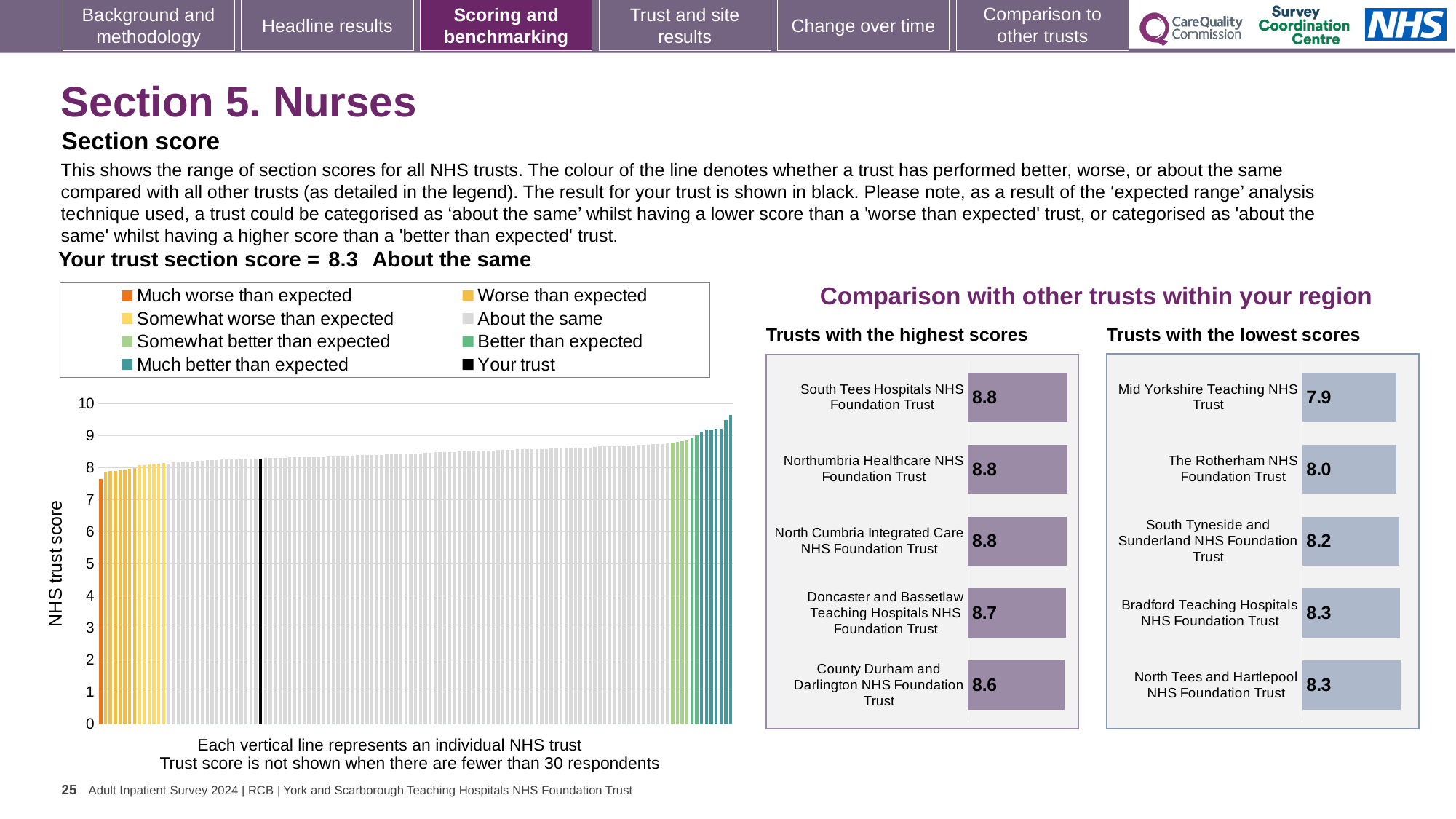
In the 'Trusts with the lowest scores' chart, which has the higher score: The Rotherham NHS Foundation Trust or South Tyneside and Sunderland NHS Foundation Trust? South Tyneside and Sunderland NHS Foundation Trust How many trusts are shown in the 'Trusts with the highest scores' chart? 5 What type of chart is the chart on the left showing NHS trust scores? Bar chart How many entries does the legend of the chart on the left list? 8 In the 'Trusts with the highest scores' chart, what is the score for Doncaster and Bassetlaw Teaching Hospitals NHS Foundation Trust? 8.7 In the 'Trusts with the lowest scores' chart, what is the difference between the scores of North Tees and Hartlepool NHS Foundation Trust and Mid Yorkshire Teaching NHS Trust? 0.4 In the chart on the left showing NHS trust scores, is the value for the black bar (your trust) greater or less than 8? greater In the 'Trusts with the lowest scores' chart, which trust has the lowest score? Mid Yorkshire Teaching NHS Trust In the 'Trusts with the highest scores' chart, what is the score for County Durham and Darlington NHS Foundation Trust? 8.6 In the 'Trusts with the lowest scores' chart, what is the score for South Tyneside and Sunderland NHS Foundation Trust? 8.2 In the 'Trusts with the lowest scores' chart, what is the score for Mid Yorkshire Teaching NHS Trust? 7.9 In the 'Trusts with the highest scores' chart, which trust has the lowest score? County Durham and Darlington NHS Foundation Trust